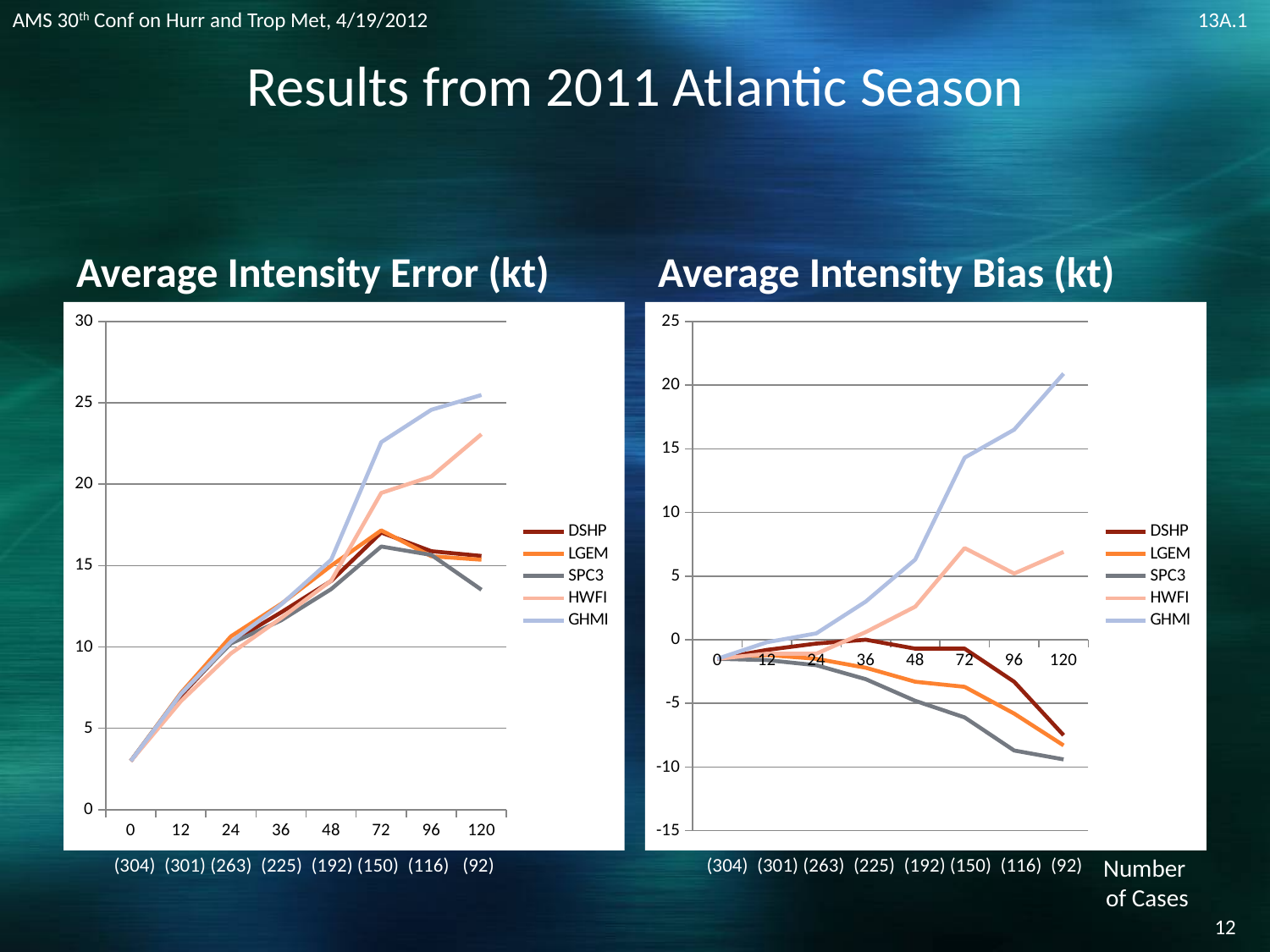
In the Average Intensity Error (kt) chart, which series has the highest value at 120 hours? GHMI In the Average Intensity Bias (kt) chart, is the value for GHMI at 72 hours greater or less than 10? greater In the Average Intensity Bias (kt) chart, does the SPC3 series rise or fall from 0 to 120 hours? fall How many series does the legend of the Average Intensity Error (kt) chart list? 5 In the Average Intensity Error (kt) chart, is the value for SPC3 at 120 hours greater or less than 15? less In the Average Intensity Bias (kt) chart, which series has the highest value at 120 hours? GHMI In the Average Intensity Error (kt) chart, which series has the lowest value at 120 hours? SPC3 What kind of chart is the Average Intensity Error (kt) chart? line chart In the Average Intensity Error (kt) chart, at 120 hours, which is larger: HWFI or DSHP? HWFI In the Average Intensity Bias (kt) chart, which series has the lowest value at 120 hours? SPC3 In the Average Intensity Error (kt) chart, is the value for GHMI at 96 hours greater or less than 20? greater How many forecast hours are plotted along the x axis of the Average Intensity Bias (kt) chart? 8